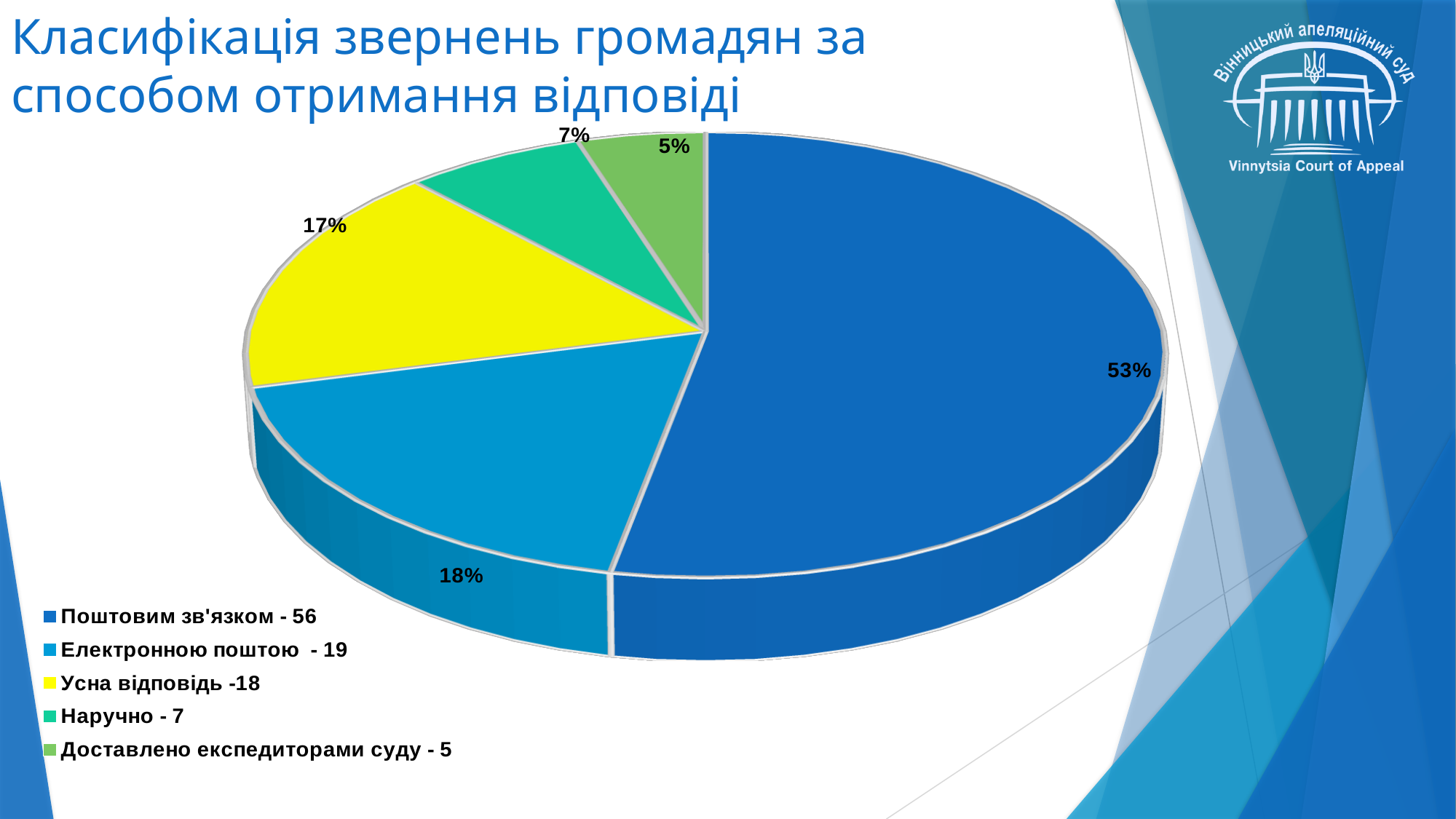
What is the difference between the number of appeals for "Поштовим зв'язком" (56) and "Електронною поштою" (19) shown in the legend? 37 What share of the pie does "Усна відповідь" take? 17% What share of the pie does "Наручно" take? 7% Which category has the smallest slice of the pie? Доставлено експедиторами суду What kind of chart is shown on the slide? pie chart Which category has the largest slice of the pie? Поштовим зв'язком How many categories does the pie chart show? 5 According to the legend, how many appeals were answered "Наручно"? 7 What share of the pie does "Електронною поштою" take? 18% Which is larger: the share for "Електронною поштою" or the share for "Усна відповідь"? Електронною поштою